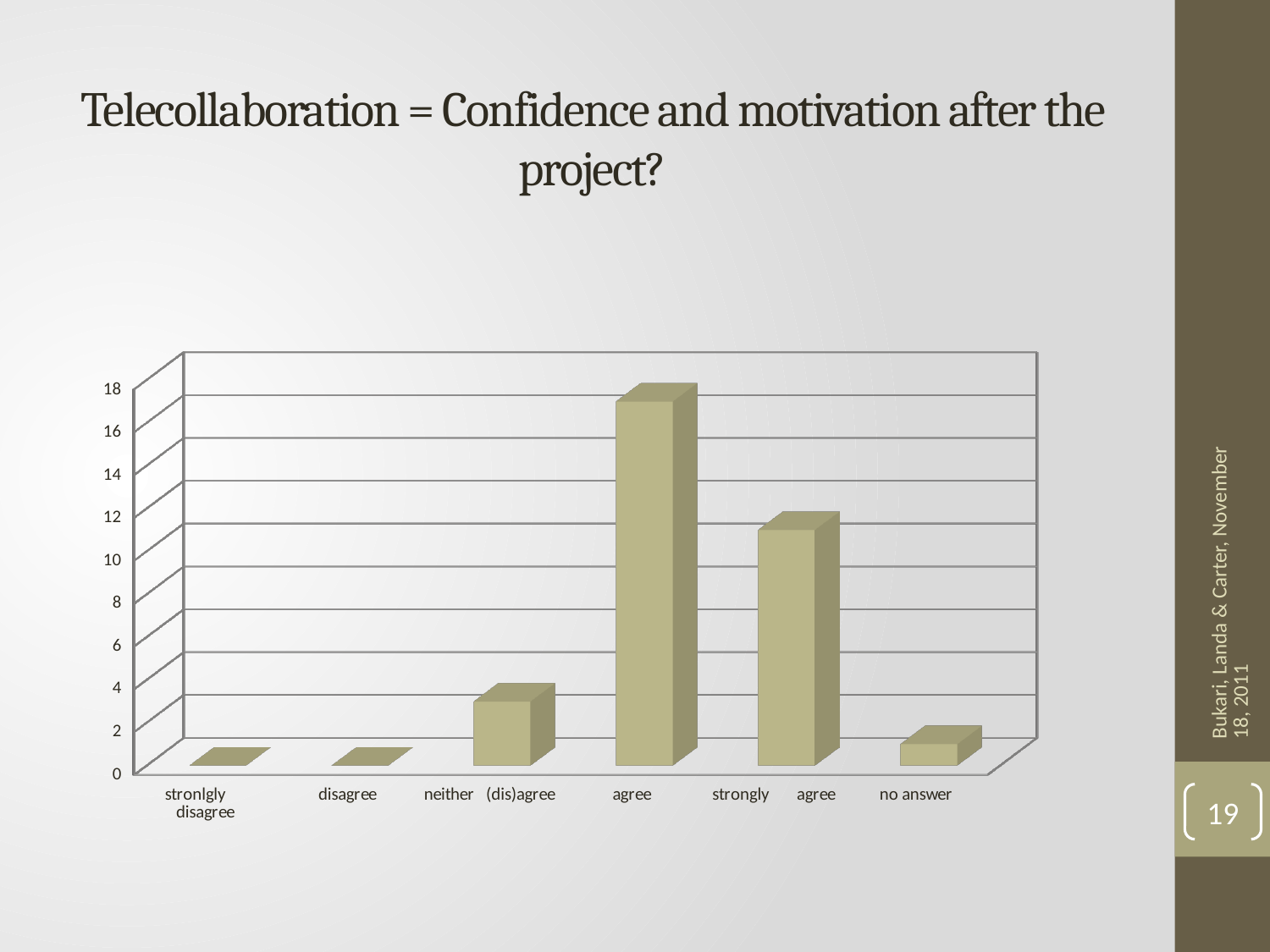
Is the value for strongly agree greater or less than 14? less What is the title of the slide containing the chart? Telecollaboration = Confidence and motivation after the project? Is the value for neither (dis)agree greater or less than 6? less Which category has the highest bar in the chart? agree What kind of chart is shown on the slide? bar chart How many categories are shown on the x axis of the chart? 6 Which is larger, the value for neither (dis)agree or the value for no answer? neither (dis)agree What is the highest value shown on the vertical axis of the chart? 18 Is the value for strongly agree greater or less than 8? greater Which is larger, the value for agree or the value for strongly agree? agree